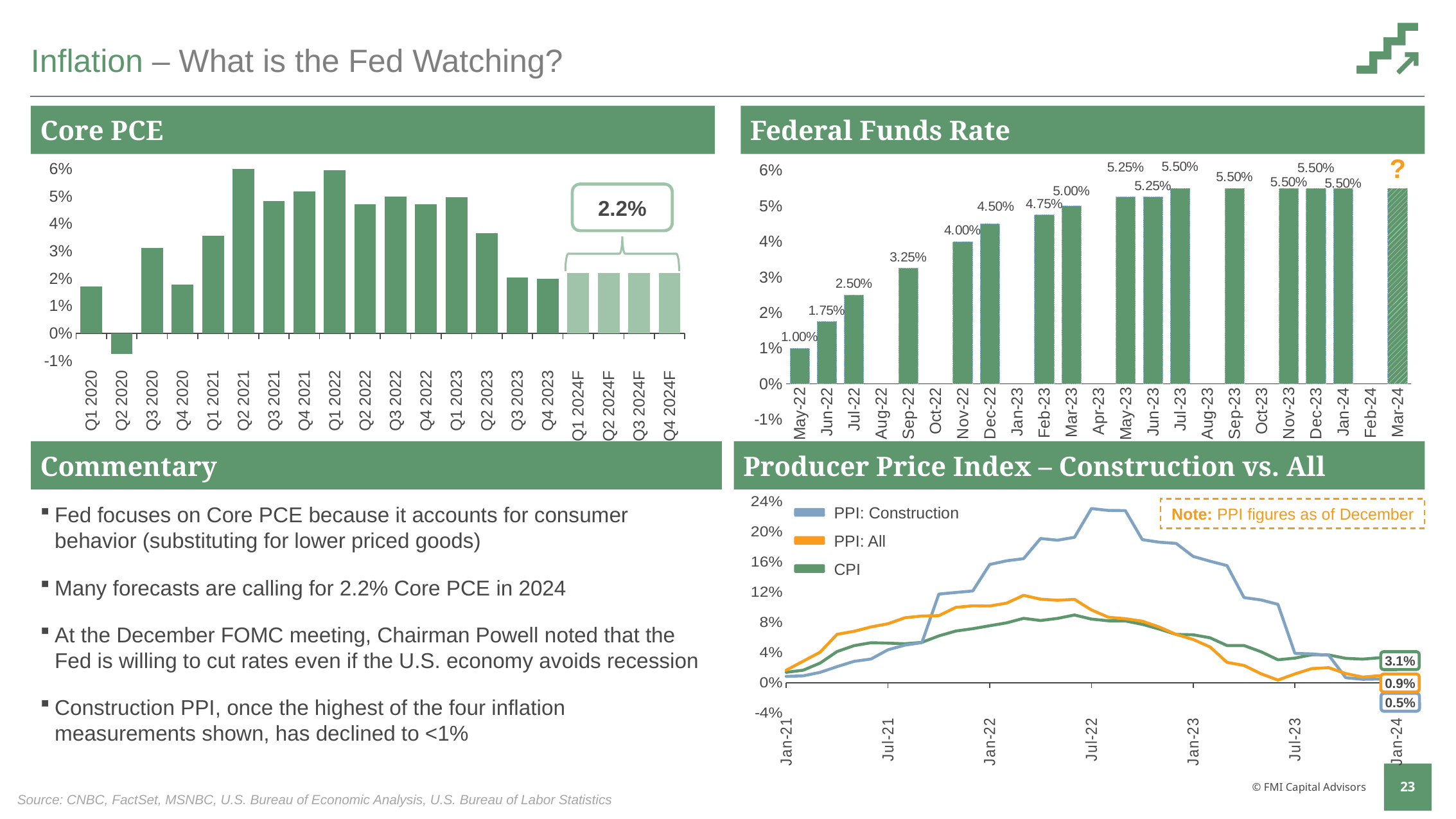
On the Core PCE chart, is the value for Q2 2020 greater or less than 0%? less On the Federal Funds Rate chart, do the values generally rise or fall from May-22 to Jan-24? rise On the Federal Funds Rate chart, what is the difference between the Jan-24 value and the May-22 value? 4.50% On the Producer Price Index – Construction vs. All chart, what is the labelled value for CPI at Jan-24? 3.1% What kind of chart is the Core PCE chart? bar chart How many series does the legend of the Producer Price Index – Construction vs. All chart list? 3 On the Federal Funds Rate chart, which month has the lowest labelled rate? May-22 On the Federal Funds Rate chart, what is the value for Sep-22? 3.25% On the Producer Price Index – Construction vs. All chart, which is larger at Jan-24: PPI: All or PPI: Construction? PPI: All On the Core PCE chart, is the value for Q2 2021 greater or less than 5%? greater On the Core PCE chart, what value is called out for the 2024F quarters? 2.2% On the Federal Funds Rate chart, what is the value for Dec-22? 4.50%